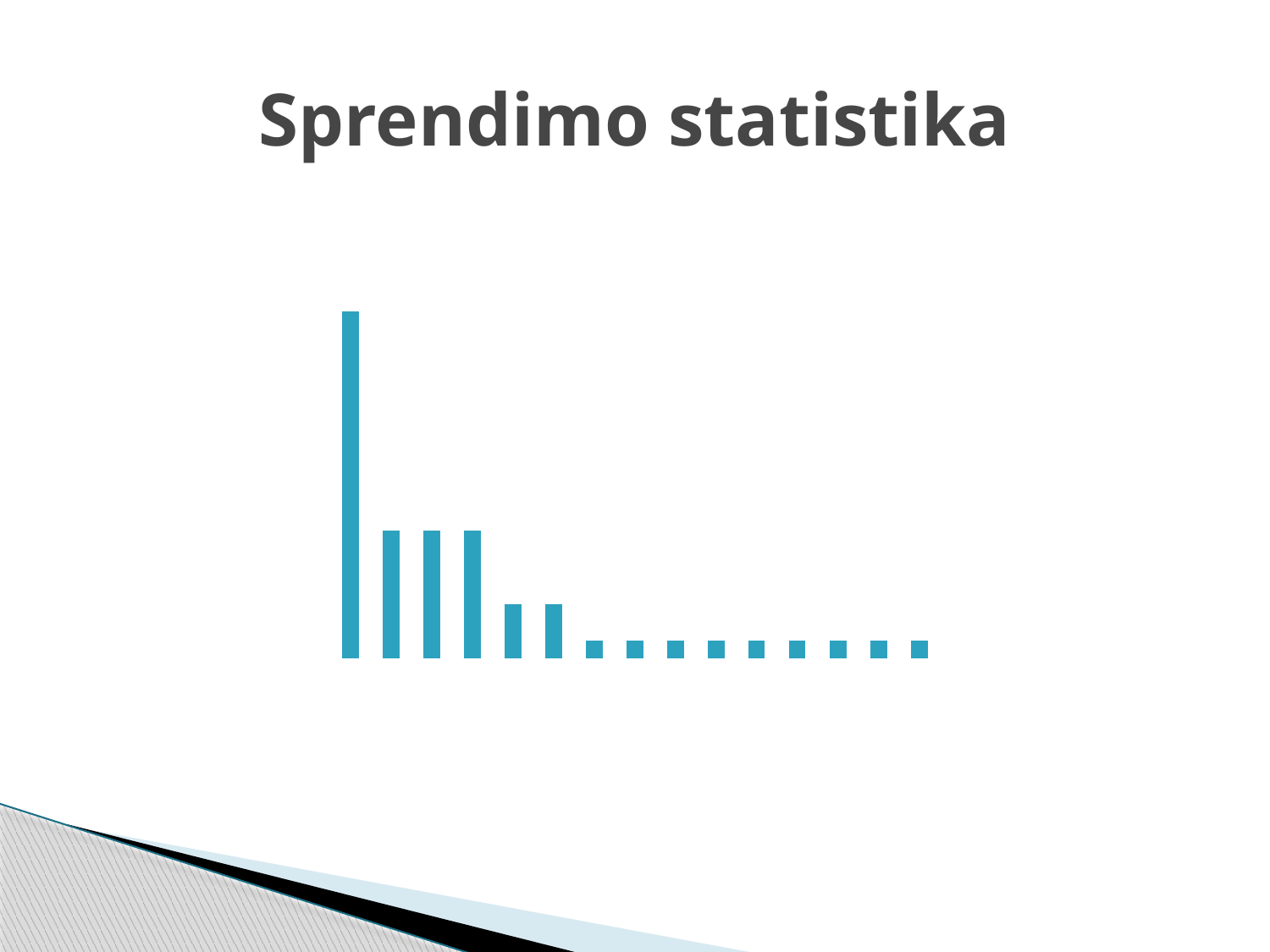
Which bar is the highest in the chart? the first (leftmost) bar How many bars does the chart contain? 15 Which is larger, the first bar or the second bar? the first bar What colour are the bars in the chart? teal blue Which is larger, the fourth bar or the fifth bar? the fourth bar Do the bar values rise or fall from left to right across the chart? fall What kind of chart is shown on the slide? bar chart Which is larger, the leftmost bar or the rightmost bar? the leftmost bar What is the title of the slide containing the chart? Sprendimo statistika